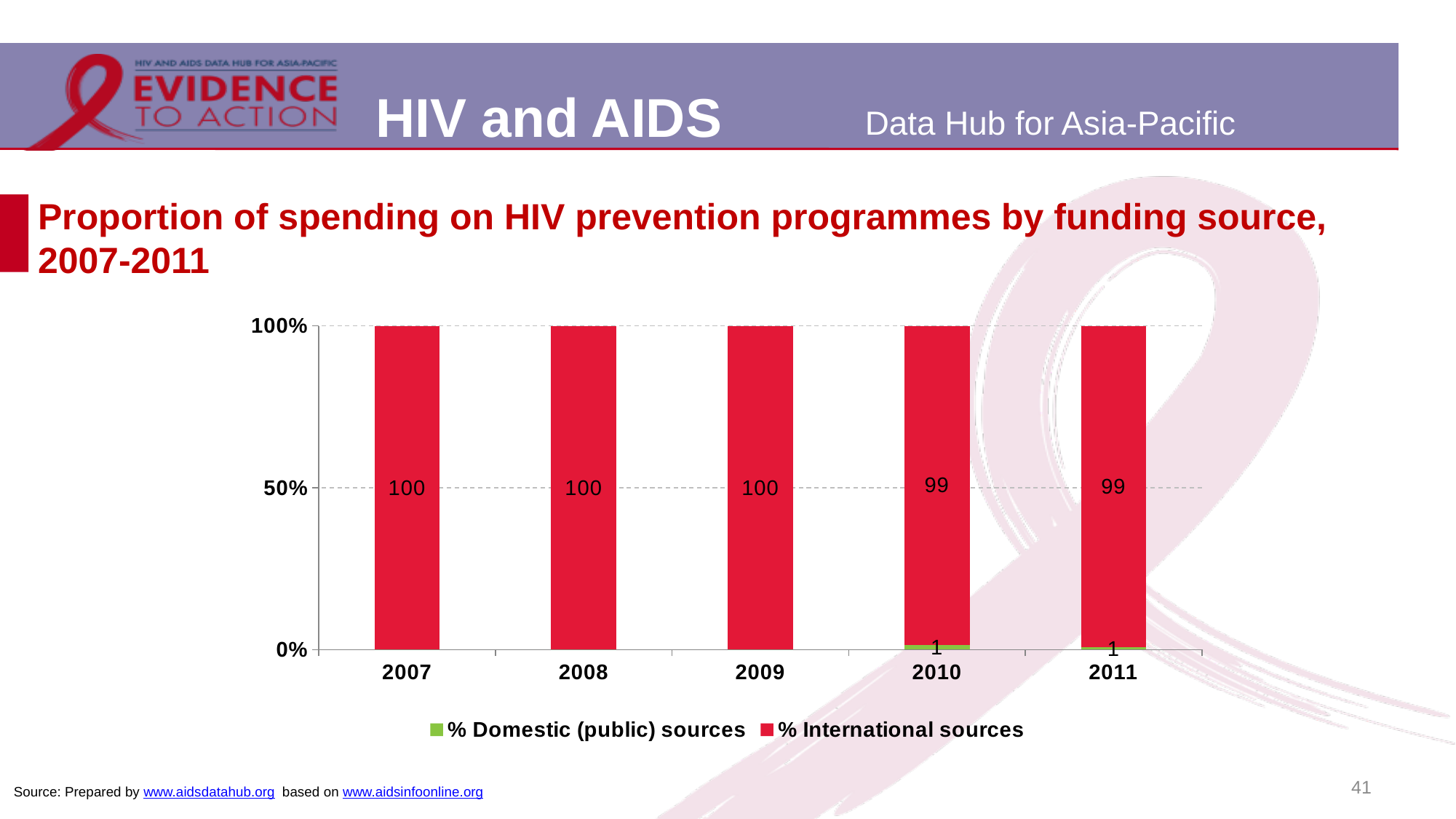
How many series does the legend list? 2 Does the % International sources value rise or fall from 2007 to 2011? Fall Which colour represents % Domestic (public) sources in the legend? Green What is the value for % International sources in 2009? 100 What kind of chart is shown on the slide? Stacked bar chart What is the difference between the % International sources value in 2008 and in 2011? 1 What is the total of the stacked bar for 2010? 100 How many years are shown on the x axis? 5 Which is larger in 2010, % International sources or % Domestic (public) sources? % International sources What is the value for % International sources in 2010? 99 What is the value for % Domestic (public) sources in 2011? 1 What is the value for % International sources in 2007? 100